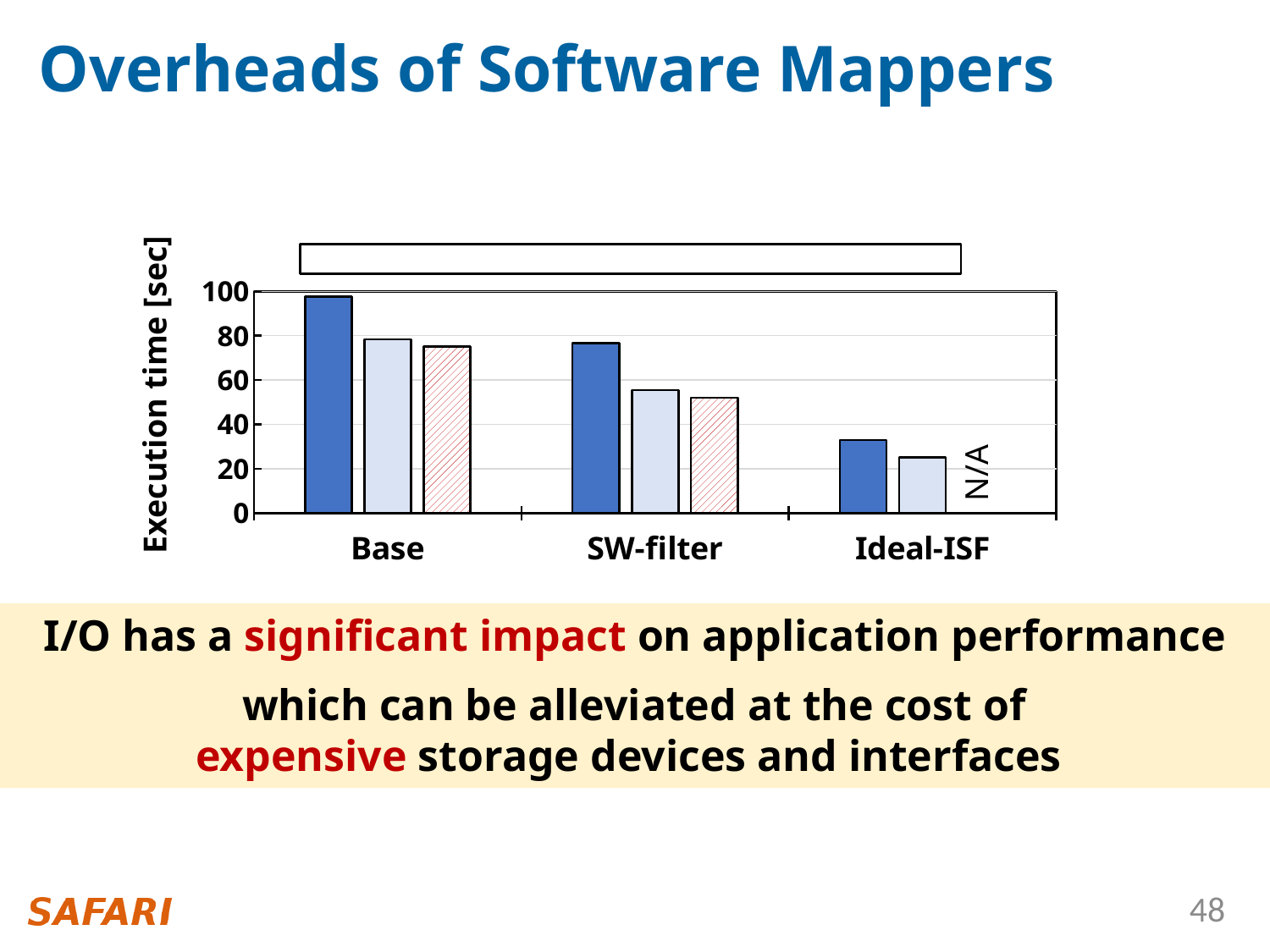
What kind of chart is shown on the slide? bar chart Is the value of the dark blue bar for SW-filter greater or less than 80? less What is shown in place of the third bar for Ideal-ISF? N/A What is the label of the y axis of the chart? Execution time [sec] Which category has the highest execution time bar in the chart? Base How many categories are shown on the x axis of the chart? 3 Which category has the lowest execution time bars in the chart? Ideal-ISF Do the execution times rise or fall moving from Base to Ideal-ISF along the x axis? fall Is the value of the red hatched bar for SW-filter greater or less than 60? less Is the value of the dark blue bar for Base greater or less than 80? greater Which is larger, the dark blue bar for Base or the dark blue bar for SW-filter? Base